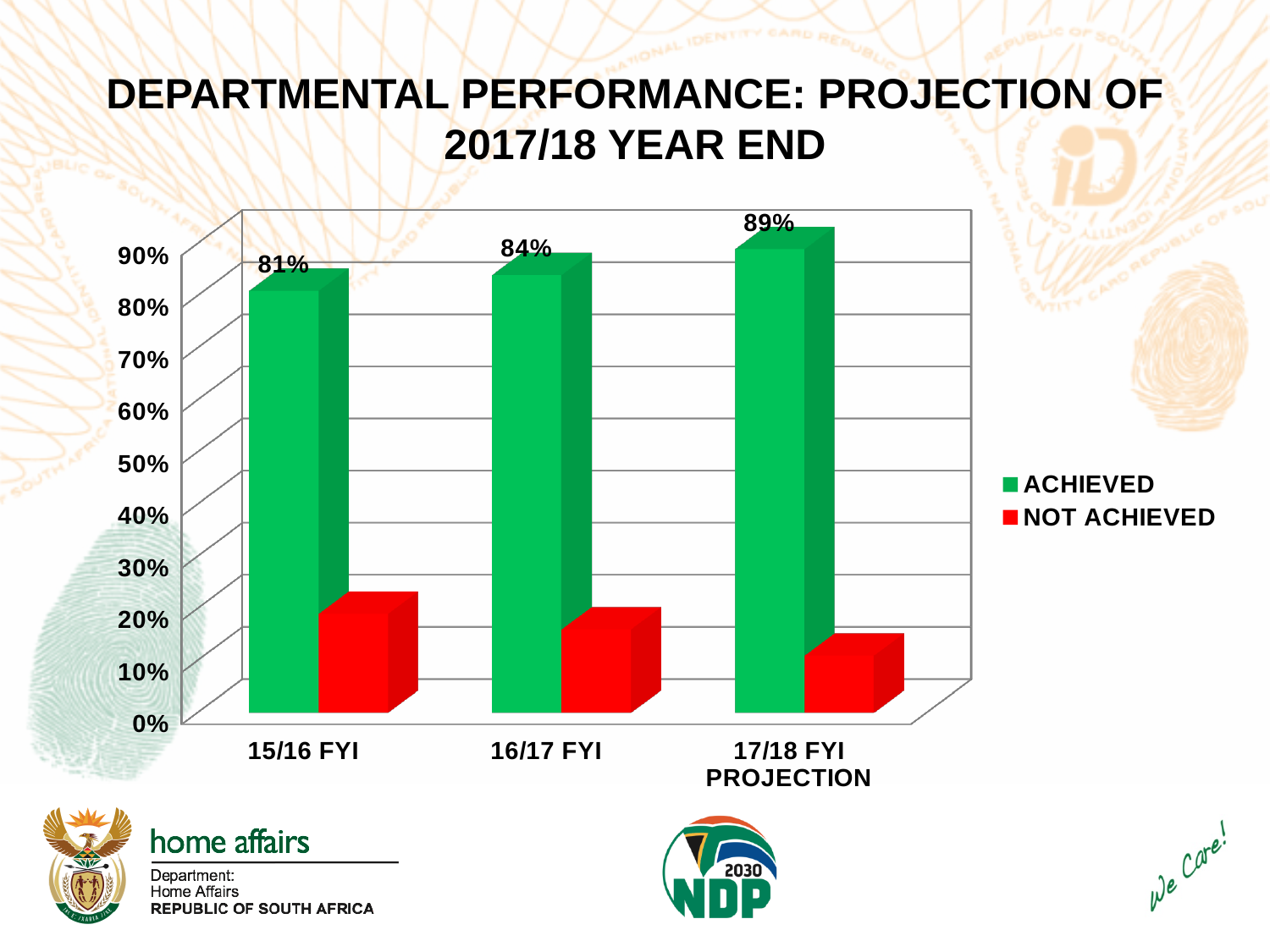
Which is larger, the ACHIEVED value for 16/17 FYI or for 17/18 FYI PROJECTION? 17/18 FYI PROJECTION Which period has the highest ACHIEVED value? 17/18 FYI PROJECTION Does the ACHIEVED value rise or fall from 15/16 FYI to 17/18 FYI PROJECTION? rise How many series does the legend list? 2 What is the ACHIEVED value for 16/17 FYI? 84% Is the NOT ACHIEVED value for 17/18 FYI PROJECTION greater or less than 20%? less What is the ACHIEVED value for 17/18 FYI PROJECTION? 89% How many periods are shown on the x axis? 3 What is the difference between the ACHIEVED values for 16/17 FYI and 15/16 FYI? 3 percentage points What is the difference between the ACHIEVED values for 17/18 FYI PROJECTION and 15/16 FYI? 8 percentage points Which period has the lowest ACHIEVED value? 15/16 FYI What is the ACHIEVED value for 15/16 FYI? 81%